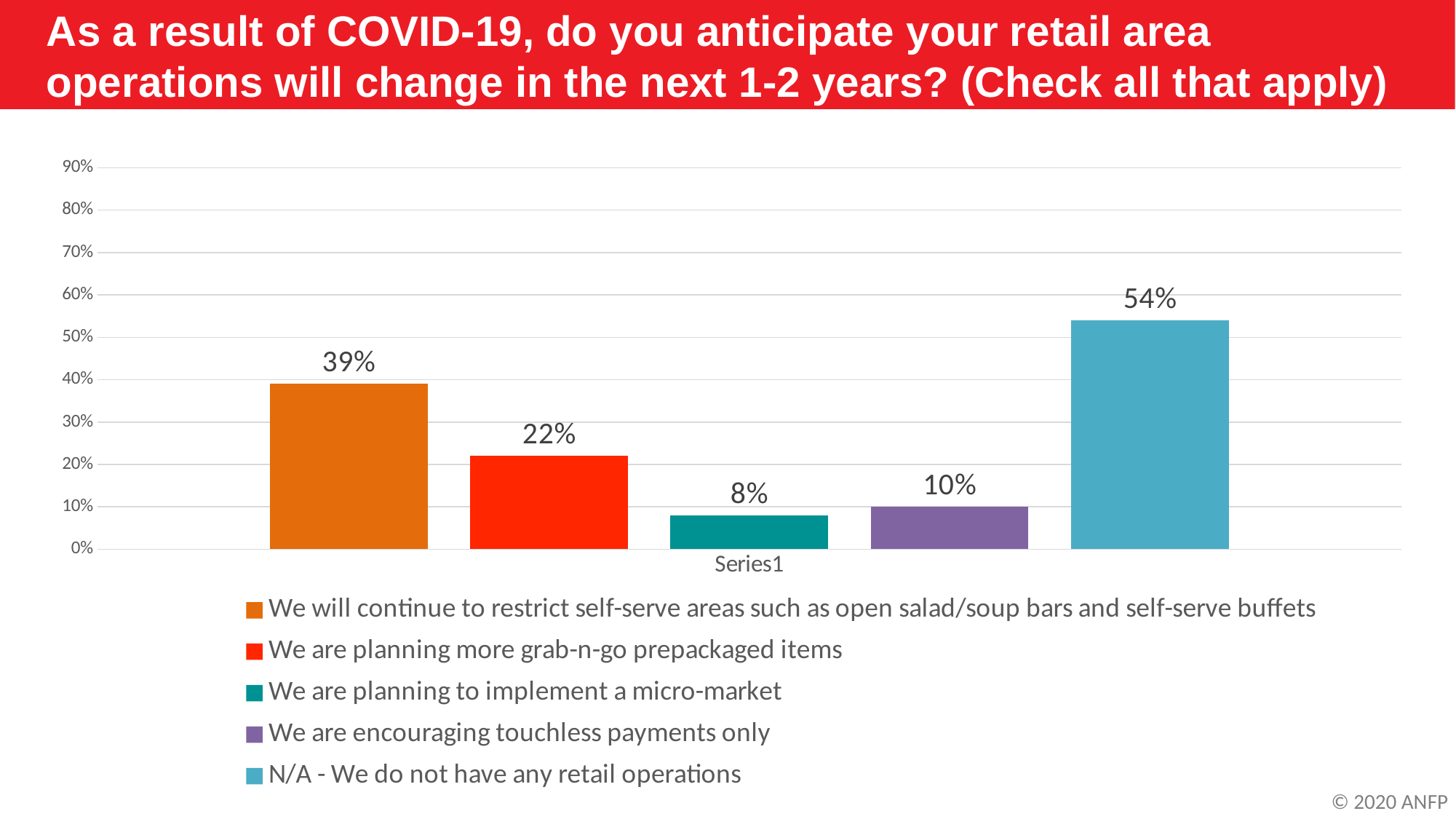
What percentage of respondents are planning to implement a micro-market? 8% What percentage of respondents are encouraging touchless payments only? 10% Which is larger: the percentage planning more grab-n-go prepackaged items or the percentage encouraging touchless payments only? We are planning more grab-n-go prepackaged items What percentage of respondents answered N/A - We do not have any retail operations? 54% What colour is the bar for the N/A - We do not have any retail operations response? Light blue What percentage of respondents said they will continue to restrict self-serve areas such as open salad/soup bars and self-serve buffets? 39% What is the difference in percentage points between the N/A response and the response about continuing to restrict self-serve areas? 15 How many response options are plotted in the chart? 5 What percentage of respondents are planning more grab-n-go prepackaged items? 22% Which response option has the highest percentage? N/A - We do not have any retail operations What type of chart is shown on the slide? Bar chart Which response option has the lowest percentage? We are planning to implement a micro-market